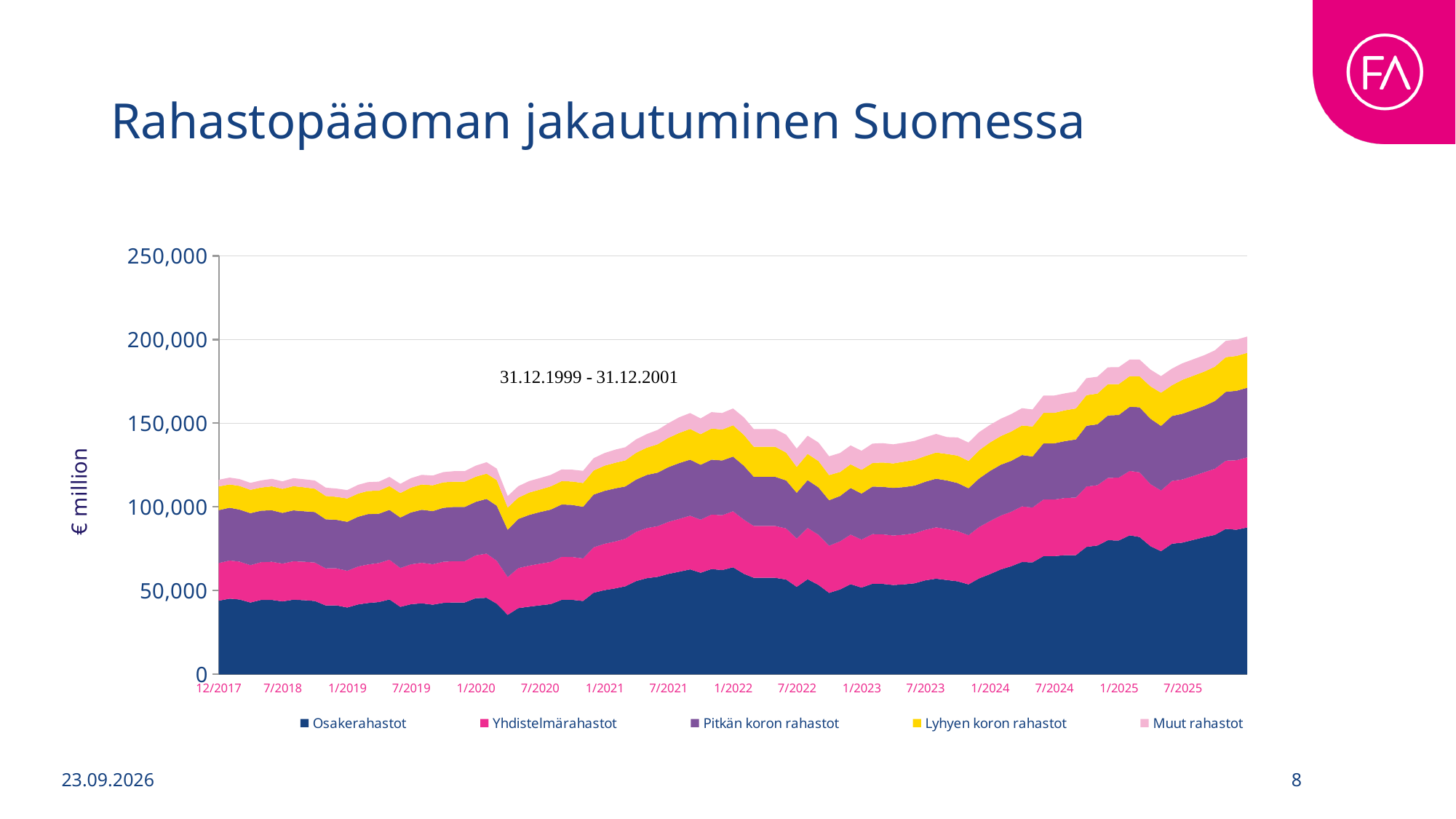
Is the total fund capital at 12/2017 greater or less than 100,000? greater How many series does the legend list? 5 Which series has the largest value at the last point on the chart? Osakerahastot Does the total fund capital rise or fall overall from 12/2017 to the end of the chart? Rise Is the total fund capital at 12/2017 greater or less than 150,000? less What kind of chart is shown on the slide? Stacked area chart What is the title of the chart? Rahastopääoman jakautuminen Suomessa Is the total fund capital at 7/2022 greater or less than 150,000? less What is the label on the vertical axis? € million Which series has the smallest value at the last point on the chart? Muut rahastot